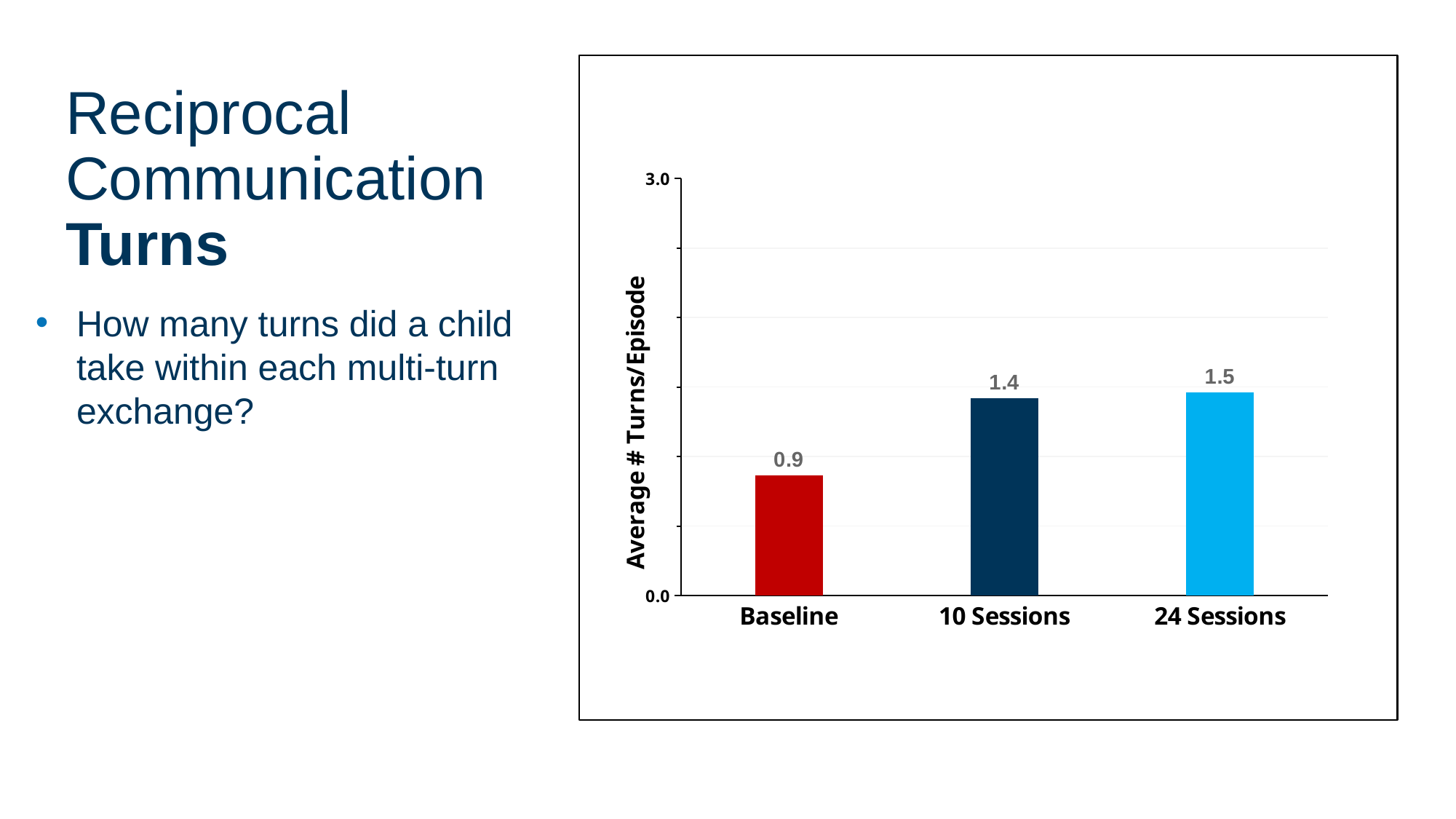
What is the label on the y axis of the chart? Average # Turns/Episode What is the difference in average turns per episode between 24 Sessions and Baseline? 0.6 Do the values rise or fall from Baseline to 24 Sessions? Rise What kind of chart is shown on the slide? Bar chart Which is larger, the value for Baseline or the value for 10 Sessions? 10 Sessions What is the average number of turns per episode at 24 Sessions? 1.5 How many categories are shown on the x axis of the chart? 3 What is the average number of turns per episode at 10 Sessions? 1.4 Which category has the lowest average number of turns per episode? Baseline What is the difference in average turns per episode between 10 Sessions and Baseline? 0.5 Which category has the highest average number of turns per episode? 24 Sessions What is the average number of turns per episode at Baseline? 0.9